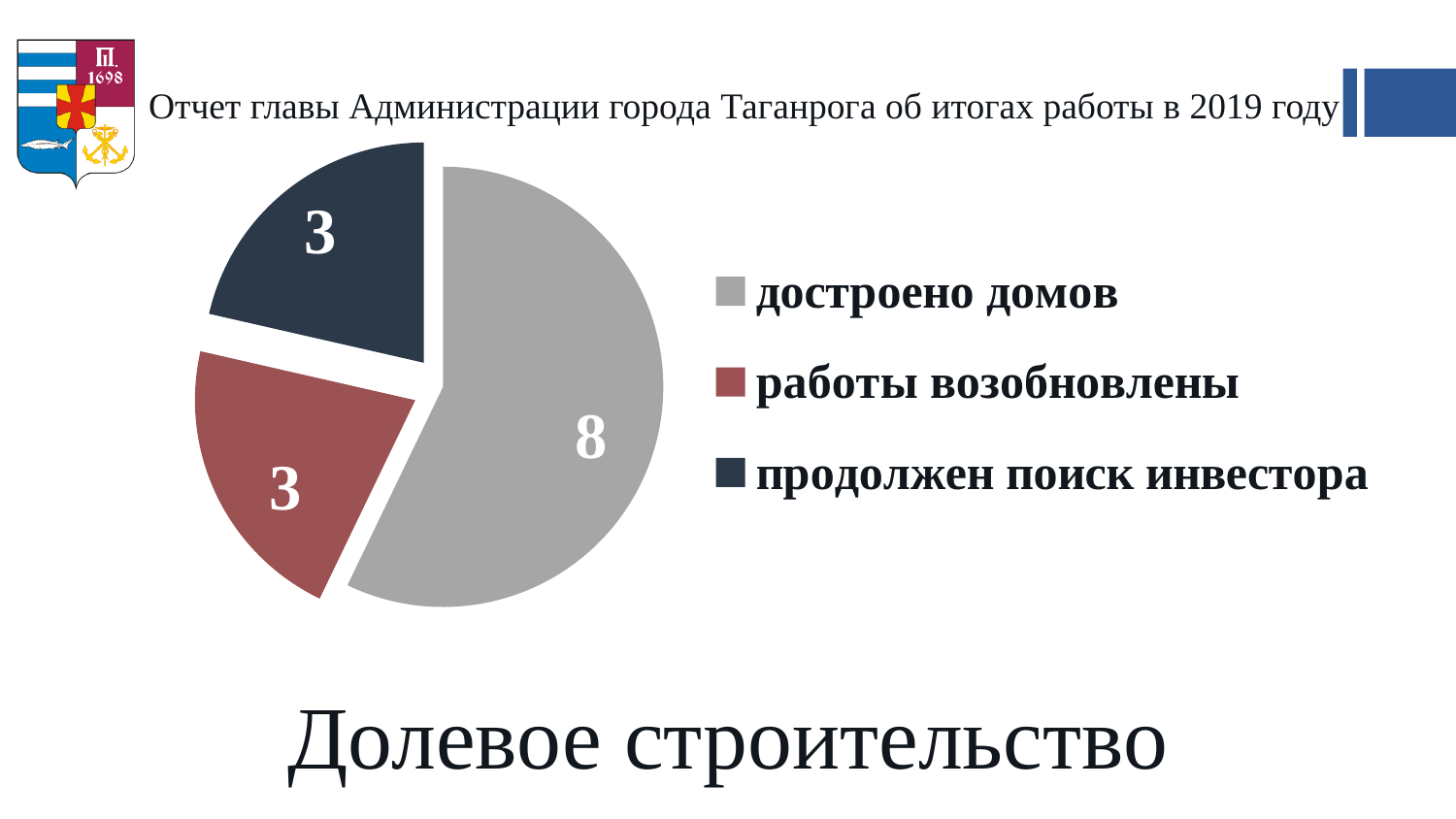
What share of the total does "достроено домов" represent, to the nearest whole percent? 57% What is the value for "работы возобновлены"? 3 What is the total of all slices in the pie chart? 14 What kind of chart is shown on the slide? pie chart What is the value for "достроено домов"? 8 Which is larger, the value for "достроено домов" or for "работы возобновлены"? достроено домов Which category has the largest slice of the pie? достроено домов What is the difference between the value for "достроено домов" and the value for "продолжен поиск инвестора"? 5 Which colour represents "продолжен поиск инвестора" in the pie chart? dark blue What is the value for "продолжен поиск инвестора"? 3 How many entries does the legend list? 3 How many slices does the pie chart have? 3